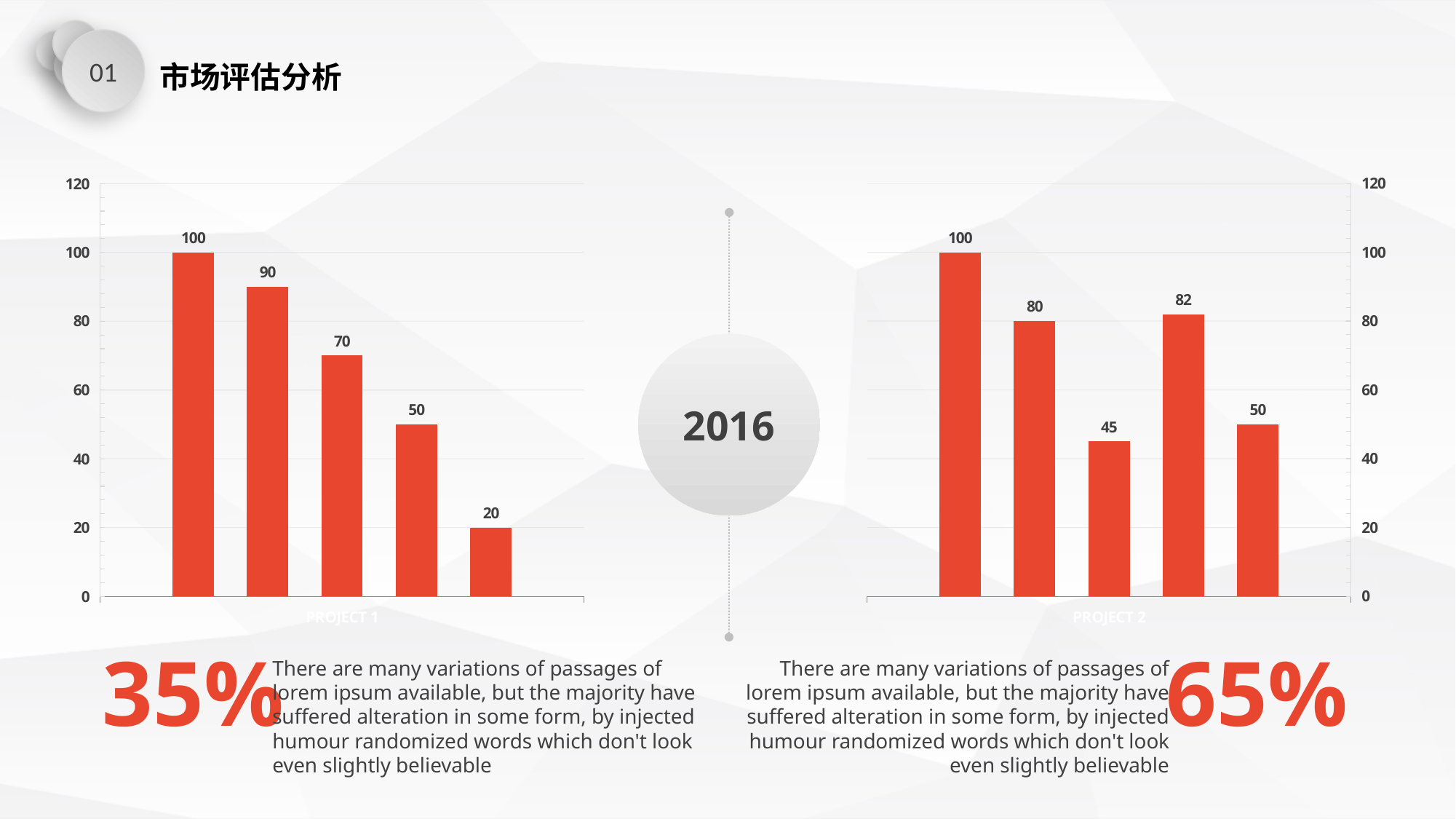
In the left chart (PROJECT 1), what is the value of the last bar? 20 In the left chart (PROJECT 1), do the values rise or fall from left to right? fall In the right chart (PROJECT 2), which is larger, the second bar or the fourth bar? the fourth bar (82) What is the maximum value shown on the vertical axis of the left chart (PROJECT 1)? 120 In the left chart (PROJECT 1), what is the difference between the first bar and the last bar? 80 In the right chart (PROJECT 2), which bar is the lowest? the third bar (45) In the right chart (PROJECT 2), what is the value of the third bar? 45 What type of chart is the left chart (PROJECT 1)? bar chart In the left chart (PROJECT 1), what is the value of the first bar? 100 In the right chart (PROJECT 2), what is the value of the fourth bar? 82 In the left chart (PROJECT 1), how many bars are plotted? 5 In the right chart (PROJECT 2), what is the difference between the second bar and the third bar? 35